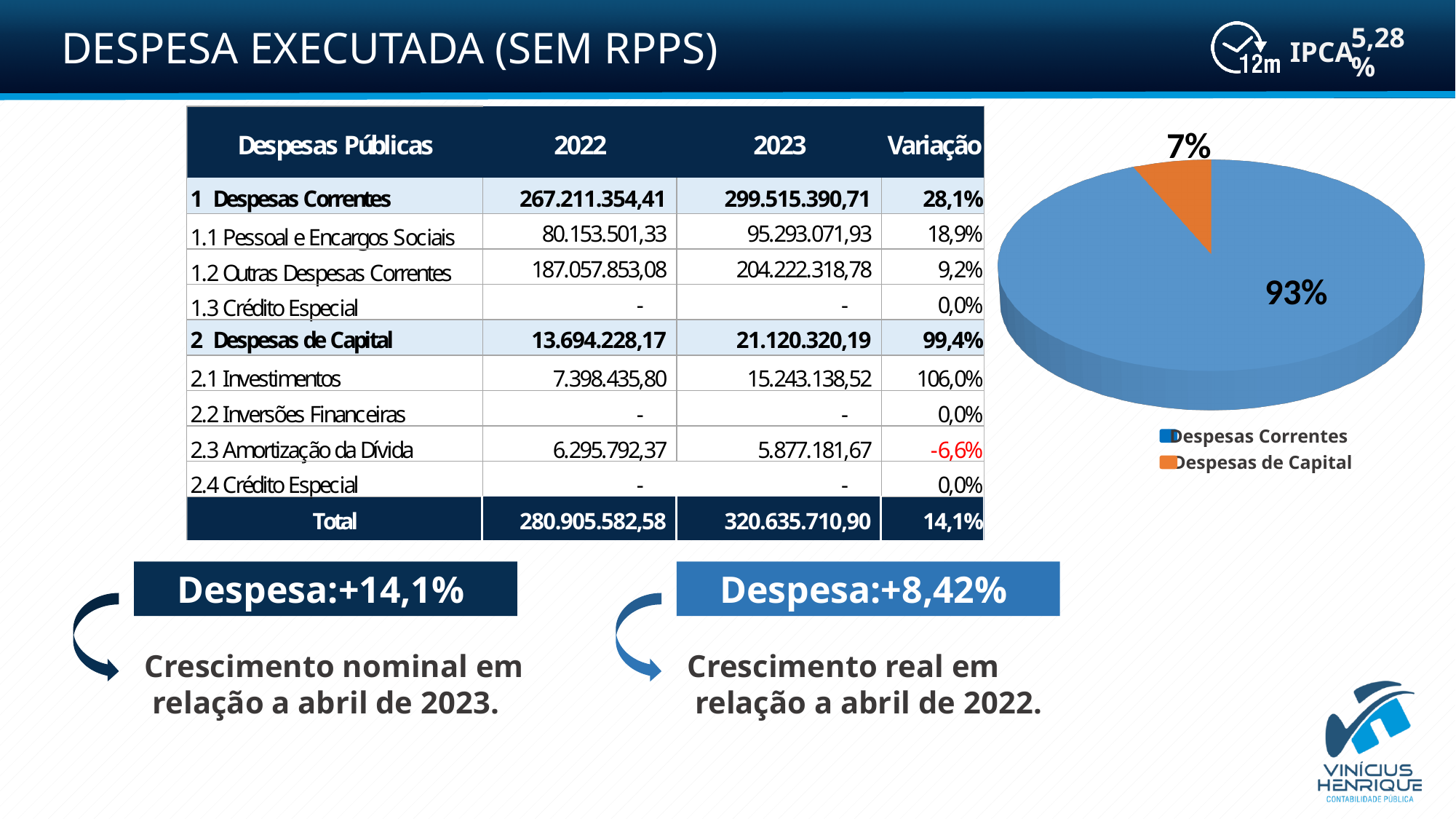
Which category has the smallest slice in the pie chart? Despesas de Capital By how many percentage points does the Despesas Correntes slice exceed the Despesas de Capital slice? 86 percentage points Is the share for Despesas de Capital in the pie chart greater or less than 10%? less What kind of chart is shown on the right side of the slide? Pie chart What share of the pie chart does Despesas Correntes represent? 93% Which is larger in the pie chart, Despesas Correntes or Despesas de Capital? Despesas Correntes Which category has the largest slice in the pie chart? Despesas Correntes How many slices does the pie chart have? 2 How many entries does the pie chart's legend list? 2 What colour is the Despesas de Capital slice in the pie chart? Orange What share of the pie chart does Despesas de Capital represent? 7% What colour is the Despesas Correntes slice in the pie chart? Blue